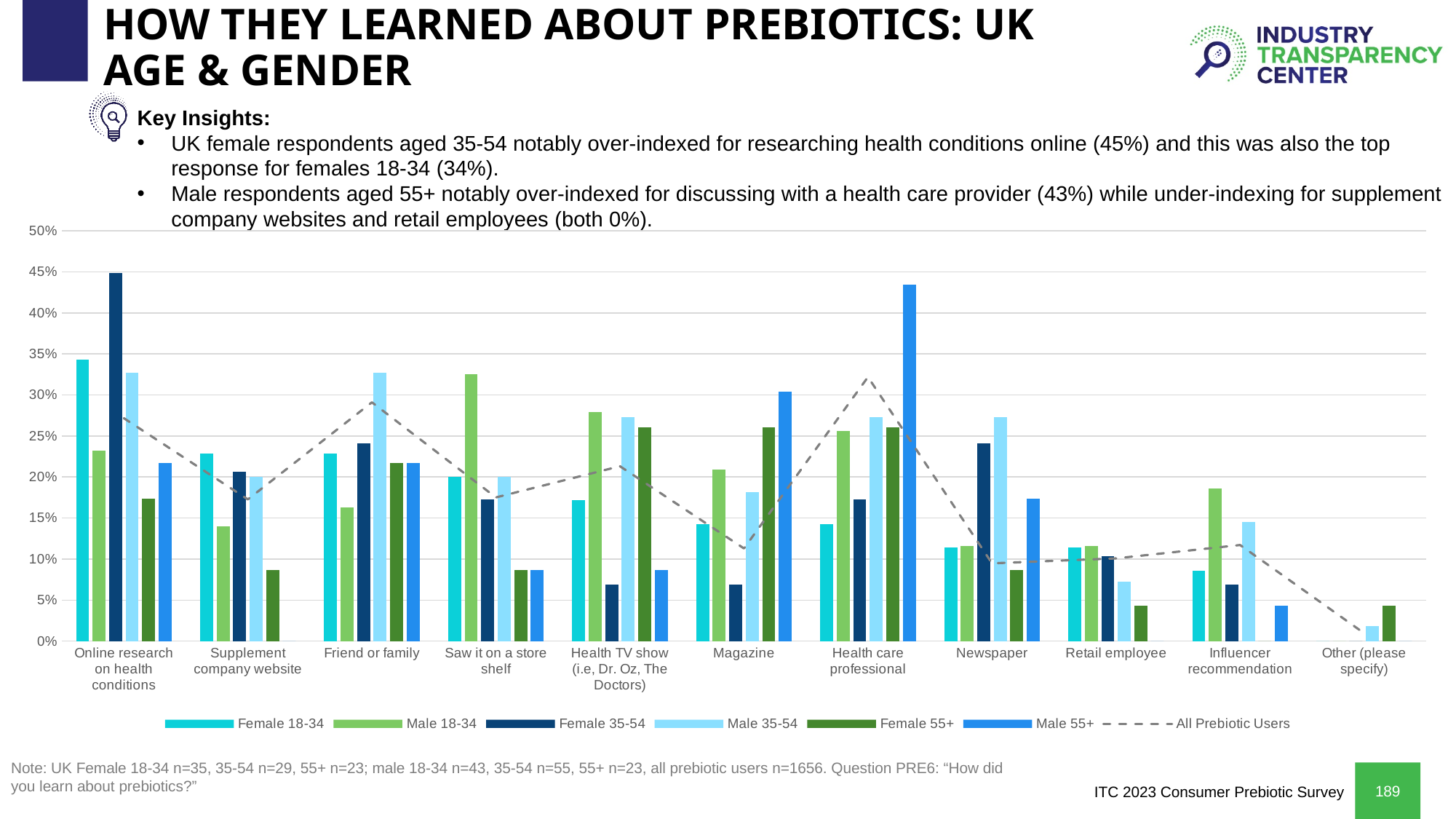
What does the dashed grey line in the chart represent? All Prebiotic Users Which category has the highest Male 55+ bar? Health care professional How many categories are shown along the x axis of the chart? 11 Is the Male 55+ value for Health care professional greater or less than 40%? greater Is the Male 35-54 value for Friend or family greater or less than 30%? greater Is the Female 55+ value for Newspaper greater or less than 10%? less How many series does the chart legend list? 7 What kind of chart is shown on the slide? combination bar and line chart Which category has the highest Female 35-54 bar? Online research on health conditions For Saw it on a store shelf, which is larger: the Male 18-34 value or the Female 18-34 value? Male 18-34